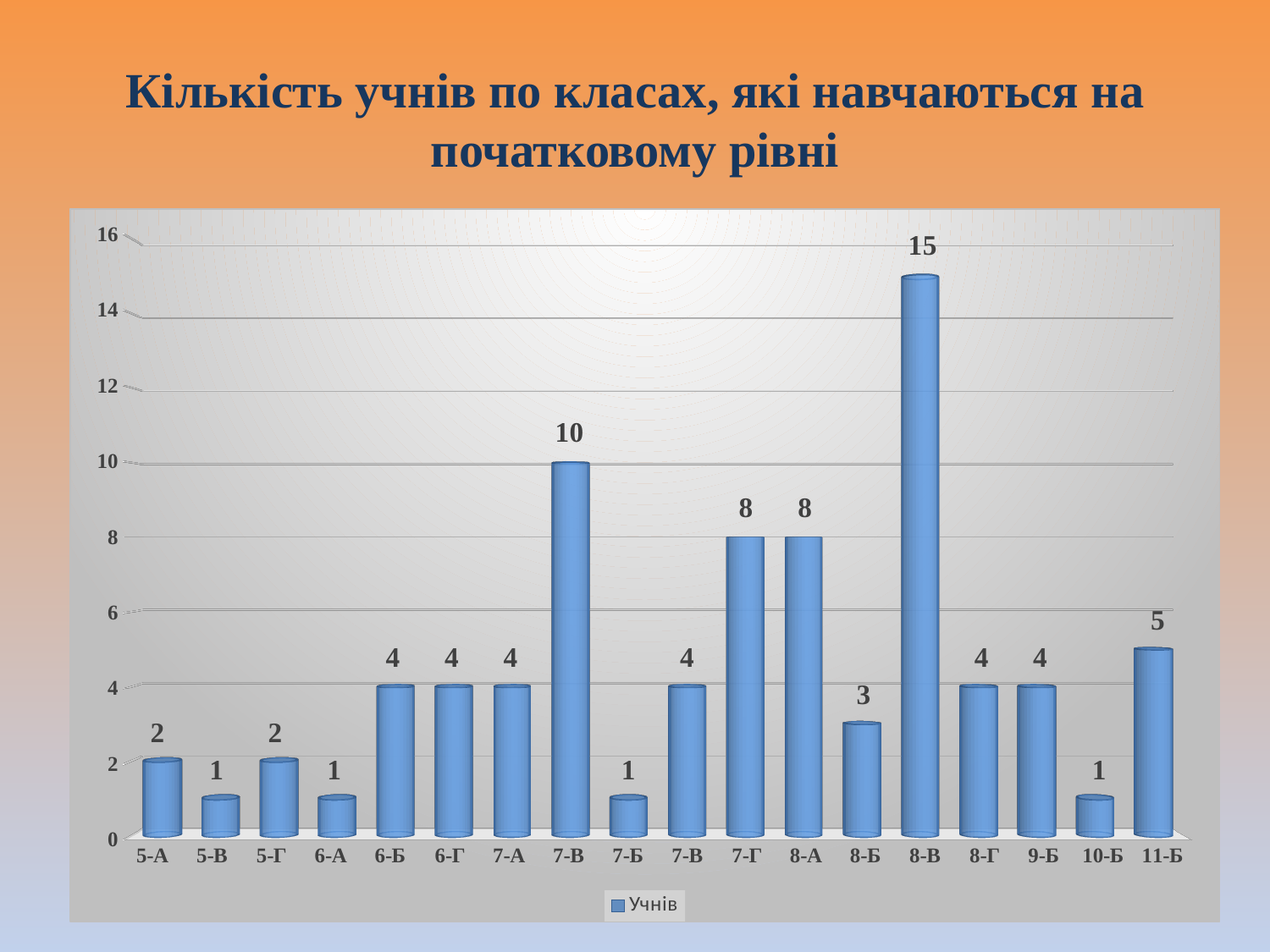
What is the legend entry for the series? Учнів How many students are shown for class 8-В? 15 What is the difference between the values for 8-В and 7-Г? 7 Which class has the highest number of students? 8-В How many series does the legend list? 1 What kind of chart is this? bar chart What is the difference between the values for 11-Б and 10-Б? 4 How many classes are shown on the x axis? 18 What is the value for class 7-Г? 8 What is the value for class 11-Б? 5 Which is larger, the value for 8-А or the value for 8-Б? 8-А What is the value for class 8-Б? 3